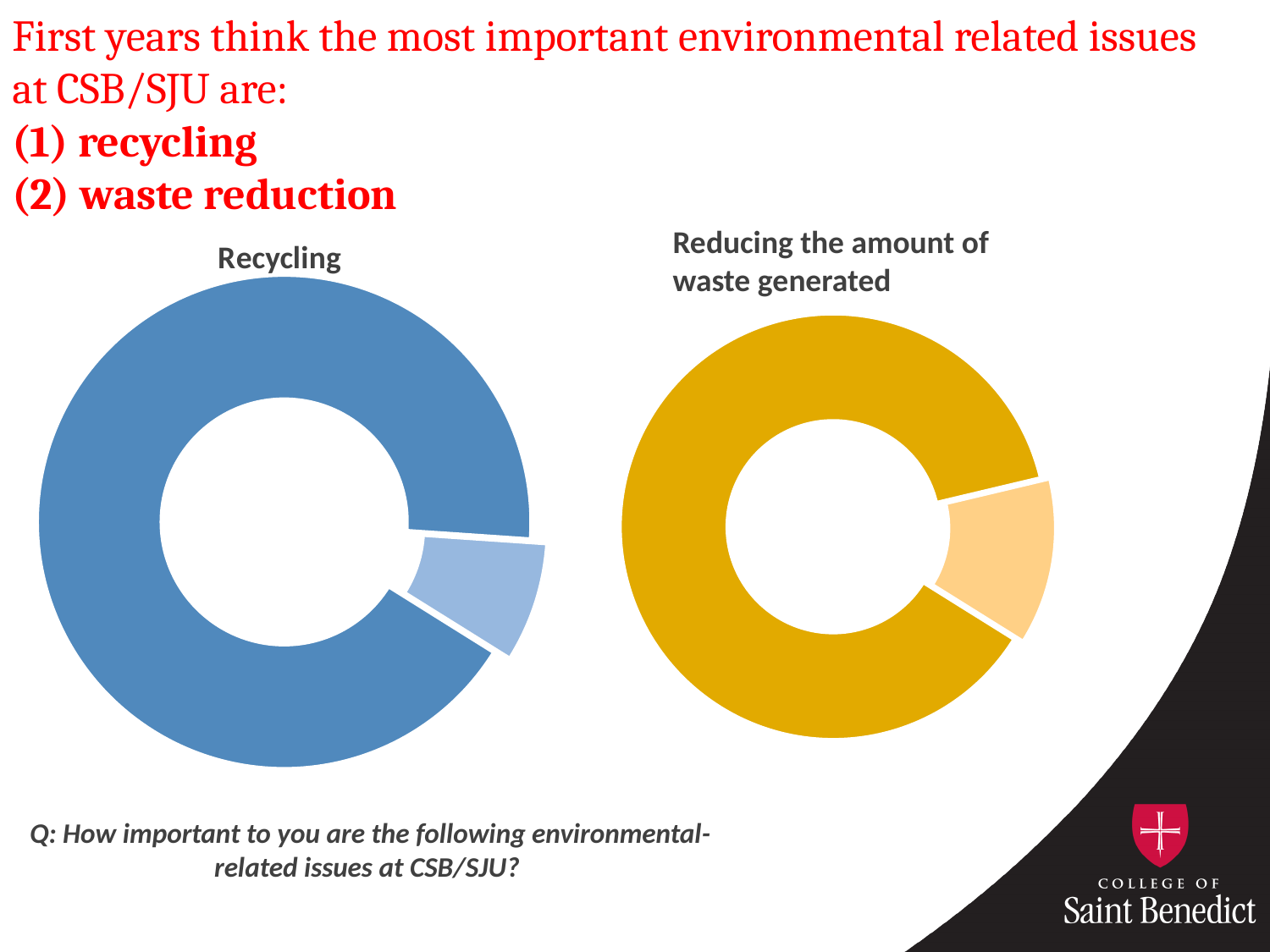
What kind of chart is the "Recycling" chart on the left? doughnut chart In the "Reducing the amount of waste generated" chart, does the dark gold slice make up more or less than half of the ring? more What is the title of the chart on the right? Reducing the amount of waste generated How many slices does the "Reducing the amount of waste generated" chart have? 2 What kind of chart is the "Reducing the amount of waste generated" chart on the right? doughnut chart What is the title of the chart on the left? Recycling How many slices does the "Recycling" chart have? 2 In the "Recycling" chart, does the light blue slice make up more or less than half of the ring? less In the "Recycling" chart, which slice is larger, the dark blue one or the light blue one? the dark blue one How many charts are shown on the slide? 2